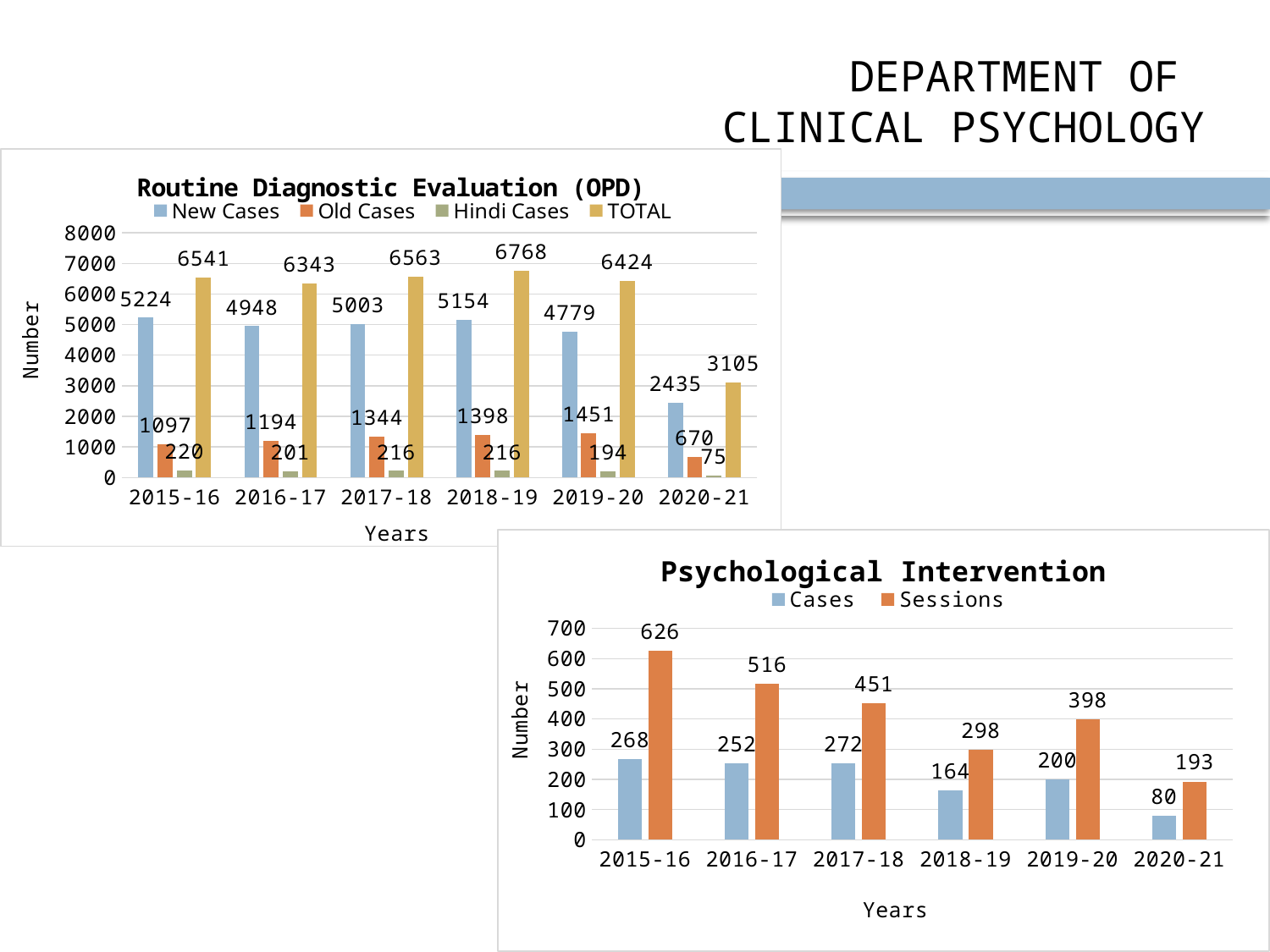
What kind of chart is the 'Psychological Intervention' chart? Bar chart In the 'Routine Diagnostic Evaluation (OPD)' chart, how many series does the legend list? 4 In the 'Routine Diagnostic Evaluation (OPD)' chart, which year has the highest TOTAL? 2018-19 In the 'Psychological Intervention' chart, is the number of Cases in 2019-20 larger than the number of Cases in 2018-19? Yes In the 'Psychological Intervention' chart, what is the difference between Sessions and Cases in 2015-16? 358 In the 'Psychological Intervention' chart, what is the number of Sessions in 2017-18? 451 In the 'Routine Diagnostic Evaluation (OPD)' chart, what is the difference between the TOTAL for 2018-19 and the TOTAL for 2019-20? 344 In the 'Routine Diagnostic Evaluation (OPD)' chart, which year has the lowest number of Old Cases? 2020-21 In the 'Psychological Intervention' chart, which year has the highest number of Sessions? 2015-16 In the 'Routine Diagnostic Evaluation (OPD)' chart, what is the value for New Cases in 2015-16? 5224 In the 'Routine Diagnostic Evaluation (OPD)' chart, what is the value for Hindi Cases in 2016-17? 201 In the 'Routine Diagnostic Evaluation (OPD)' chart, what is the TOTAL for 2020-21? 3105